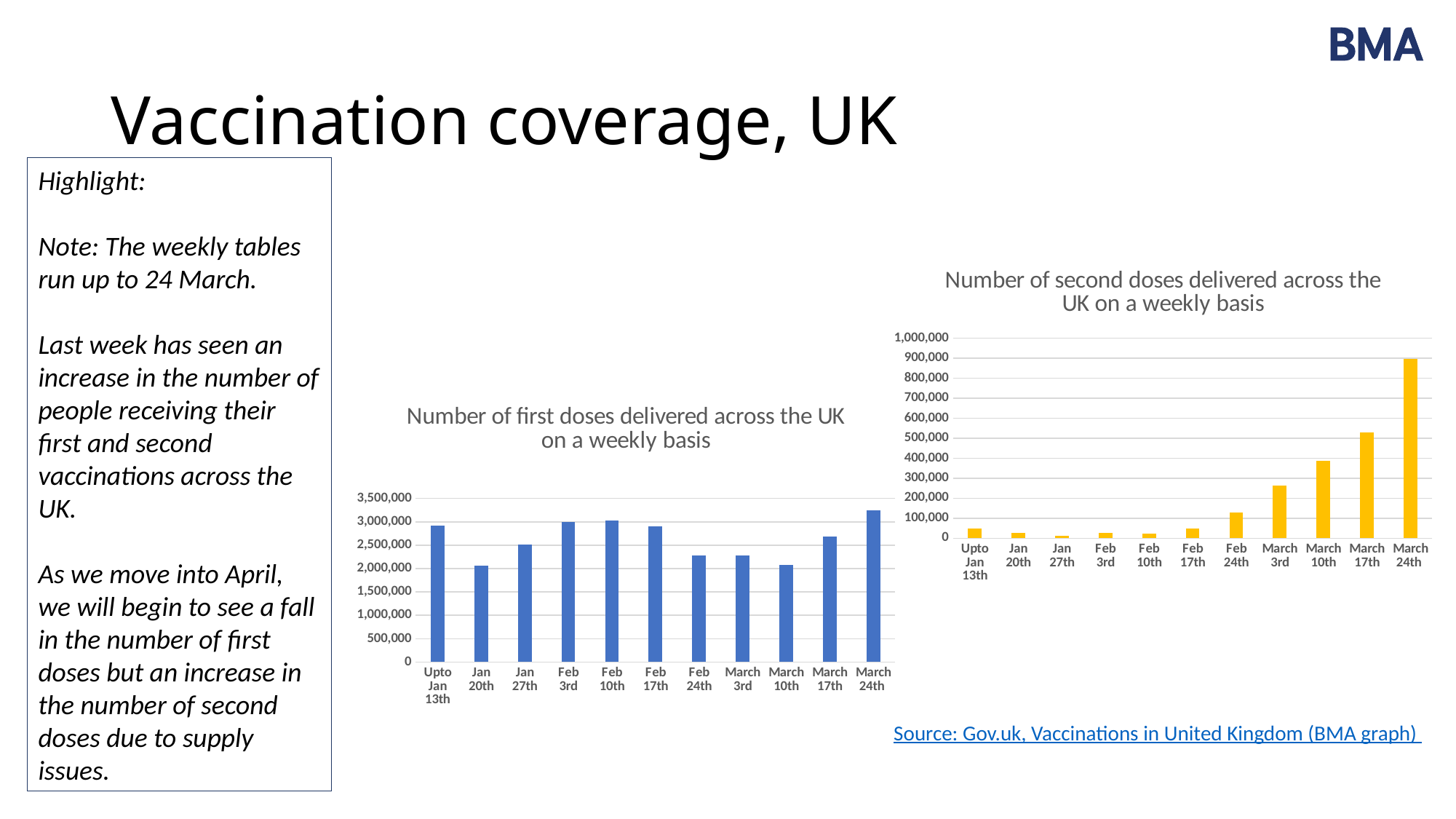
In the 'Number of second doses delivered across the UK on a weekly basis' chart, which week has the lowest number of second doses? Jan 27th In the 'Number of second doses delivered across the UK on a weekly basis' chart, do the values rise or fall from Feb 17th to March 24th? Rise What kind of chart is the 'Number of first doses delivered across the UK on a weekly basis' chart? Bar chart In the 'Number of first doses delivered across the UK on a weekly basis' chart, which week has the highest number of first doses? March 24th In the 'Number of first doses delivered across the UK on a weekly basis' chart, is the value for Jan 20th greater or less than 2,500,000? less In the 'Number of second doses delivered across the UK on a weekly basis' chart, which week has the highest number of second doses? March 24th In the 'Number of second doses delivered across the UK on a weekly basis' chart, which is larger: the value for March 17th or the value for March 10th? March 17th In the 'Number of second doses delivered across the UK on a weekly basis' chart, is the value for March 17th greater or less than 500,000? greater How many weekly categories are shown on the x axis of the 'Number of second doses delivered across the UK on a weekly basis' chart? 11 In the 'Number of first doses delivered across the UK on a weekly basis' chart, which is larger: the value for Feb 3rd or the value for Jan 20th? Feb 3rd In the 'Number of second doses delivered across the UK on a weekly basis' chart, is the value for March 3rd greater or less than 300,000? less